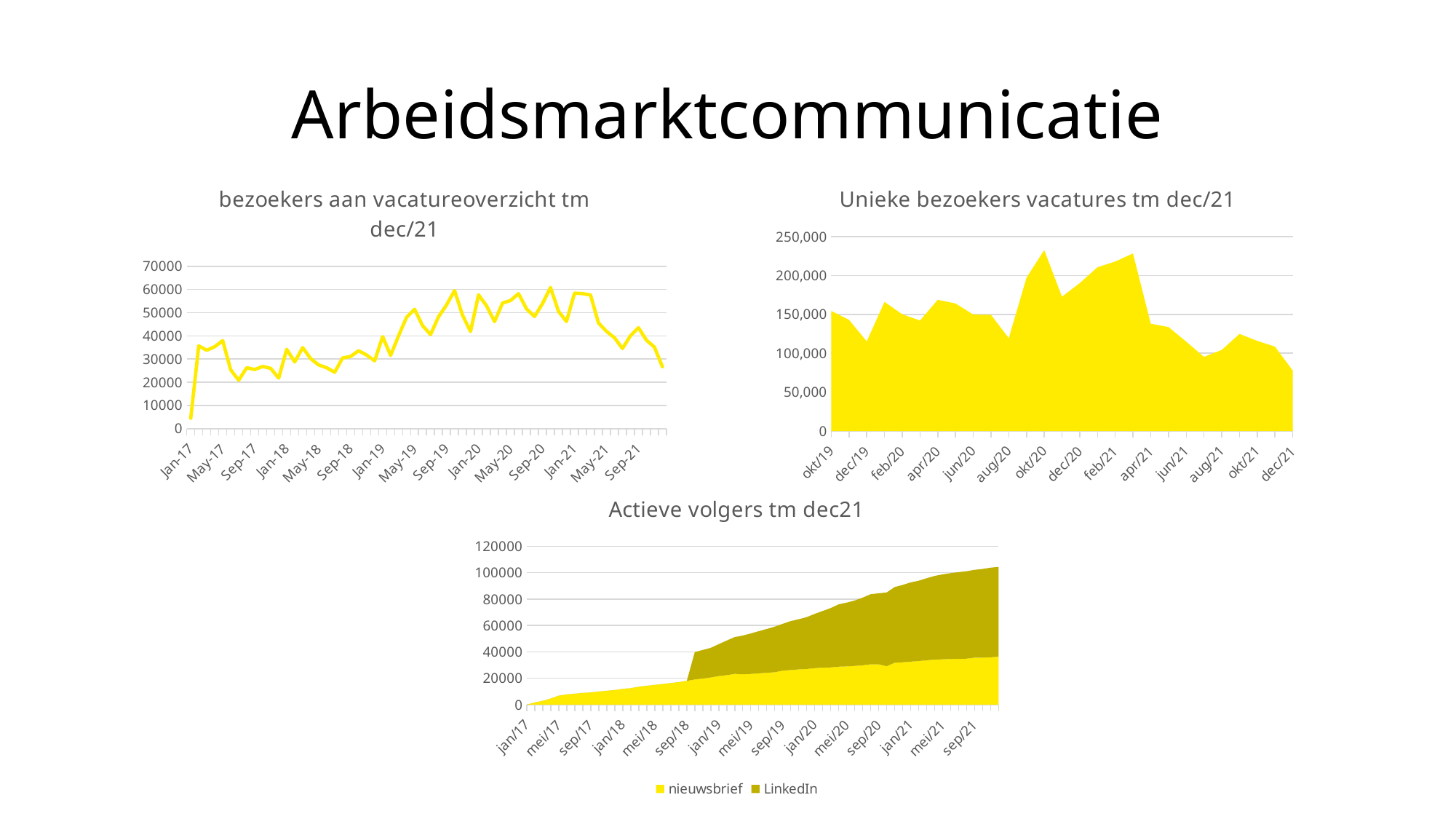
What kind of chart is 'bezoekers aan vacatureoverzicht tm dec/21'? line chart In the chart 'Unieke bezoekers vacatures tm dec/21', is the value for okt/20 greater or less than 200,000? greater In the chart 'Actieve volgers tm dec21', do the total values rise or fall from jan/17 to the end of the x axis? rise In the chart 'Unieke bezoekers vacatures tm dec/21', is the value for dec/21 greater or less than 100,000? less In the chart 'bezoekers aan vacatureoverzicht tm dec/21', which month has the lowest value? Jan-17 How many series does the legend of the chart 'Actieve volgers tm dec21' list? 2 In the chart 'Actieve volgers tm dec21', which series is larger at the last point on the x axis, nieuwsbrief or LinkedIn? LinkedIn In the chart 'Unieke bezoekers vacatures tm dec/21', which is larger, the value for okt/20 or the value for aug/20? okt/20 What kind of chart is 'Unieke bezoekers vacatures tm dec/21'? area chart In the chart 'bezoekers aan vacatureoverzicht tm dec/21', is the value for Jan-17 greater or less than 10000? less In the chart 'Unieke bezoekers vacatures tm dec/21', which month has the lowest value? dec/21